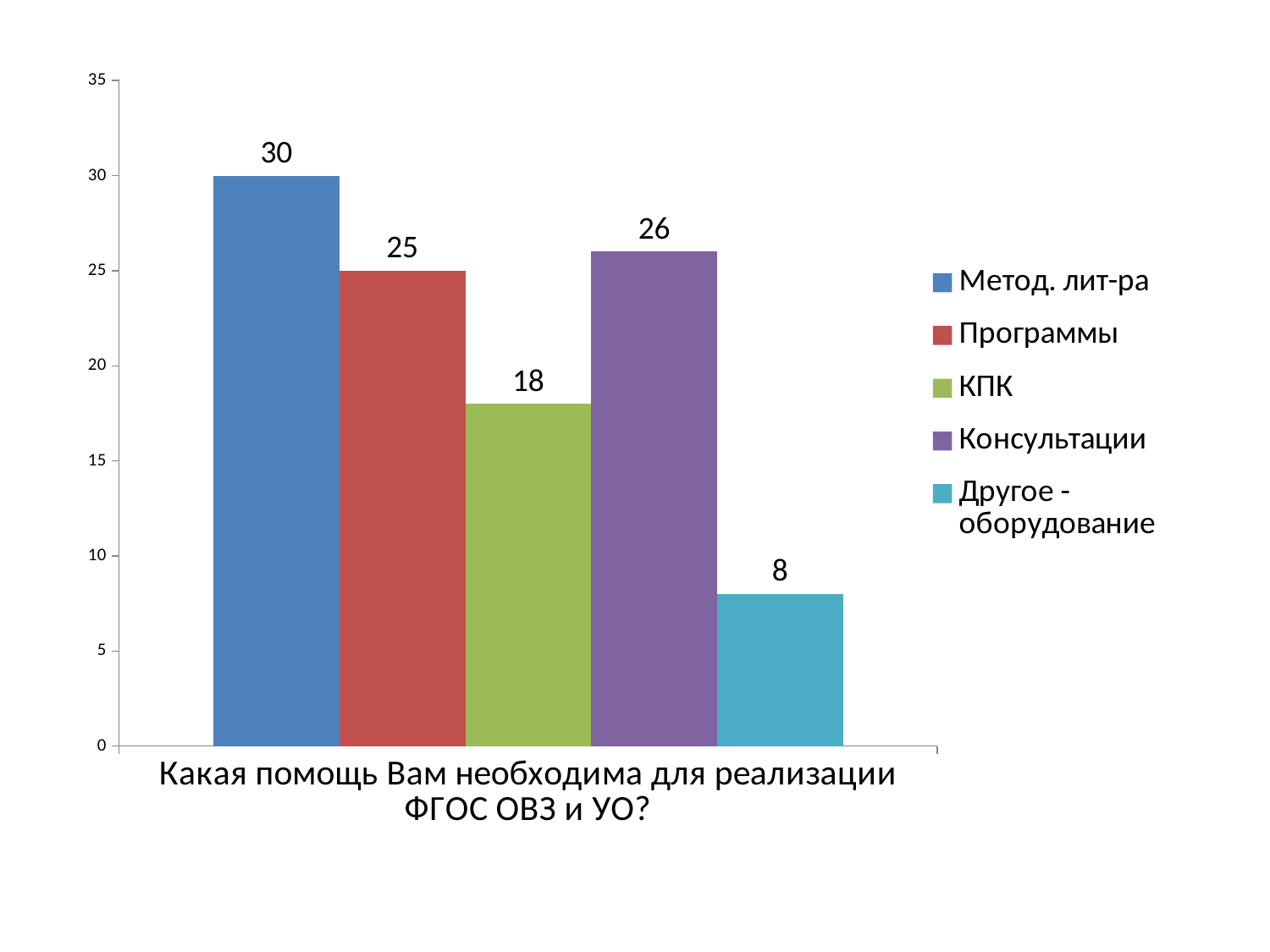
How many series does the legend list? 5 What is the value for Метод. лит-ра? 30 What is the difference between the values for Метод. лит-ра and Другое - оборудование? 22 Which series has the lowest value? Другое - оборудование What is the value for Программы? 25 What is the value for Другое - оборудование? 8 What kind of chart is shown on the slide? bar chart Which series has the highest value? Метод. лит-ра Which is larger, the value for Программы or the value for КПК? Программы What is the value for КПК? 18 What is the value for Консультации? 26 What is the category label shown under the bars on the x axis? Какая помощь Вам необходима для реализации ФГОС ОВЗ и УО?